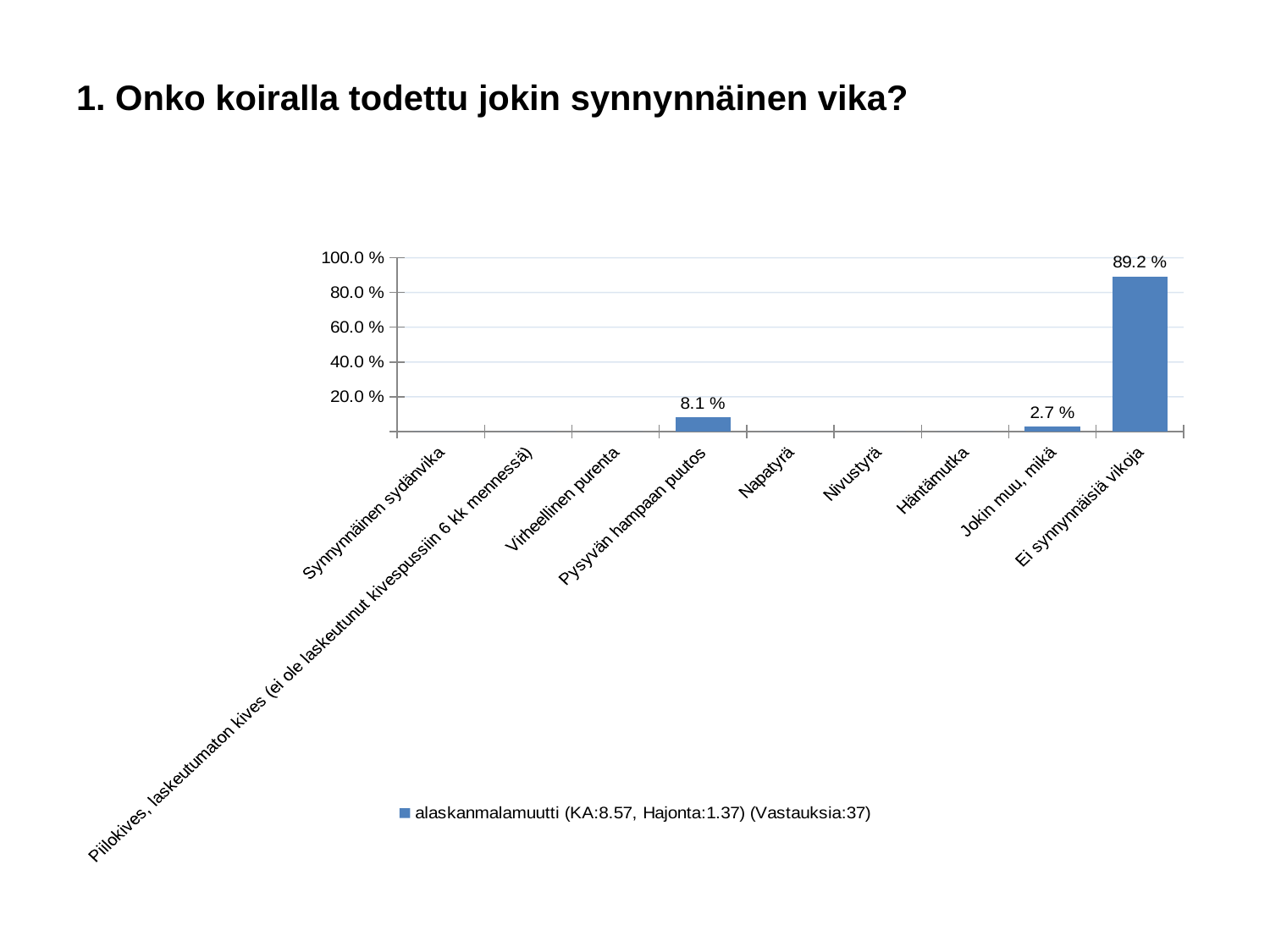
Is the value for "Ei synnynnäisiä vikoja" greater or less than 80.0 %? greater Which is larger, the value for "Pysyvän hampaan puutos" or the value for "Jokin muu, mikä"? Pysyvän hampaan puutos What is the difference between the values for "Pysyvän hampaan puutos" and "Jokin muu, mikä"? 5.4 % How many categories are shown on the x axis? 9 How many series does the legend list? 1 What is the value for "Pysyvän hampaan puutos"? 8.1 % Which category has the highest value? Ei synnynnäisiä vikoja What is the value for "Ei synnynnäisiä vikoja"? 89.2 % What is the title of the slide? 1. Onko koiralla todettu jokin synnynnäinen vika? What kind of chart is shown on the slide? bar chart What is the value for "Jokin muu, mikä"? 2.7 % What is the difference between the values for "Ei synnynnäisiä vikoja" and "Pysyvän hampaan puutos"? 81.1 %